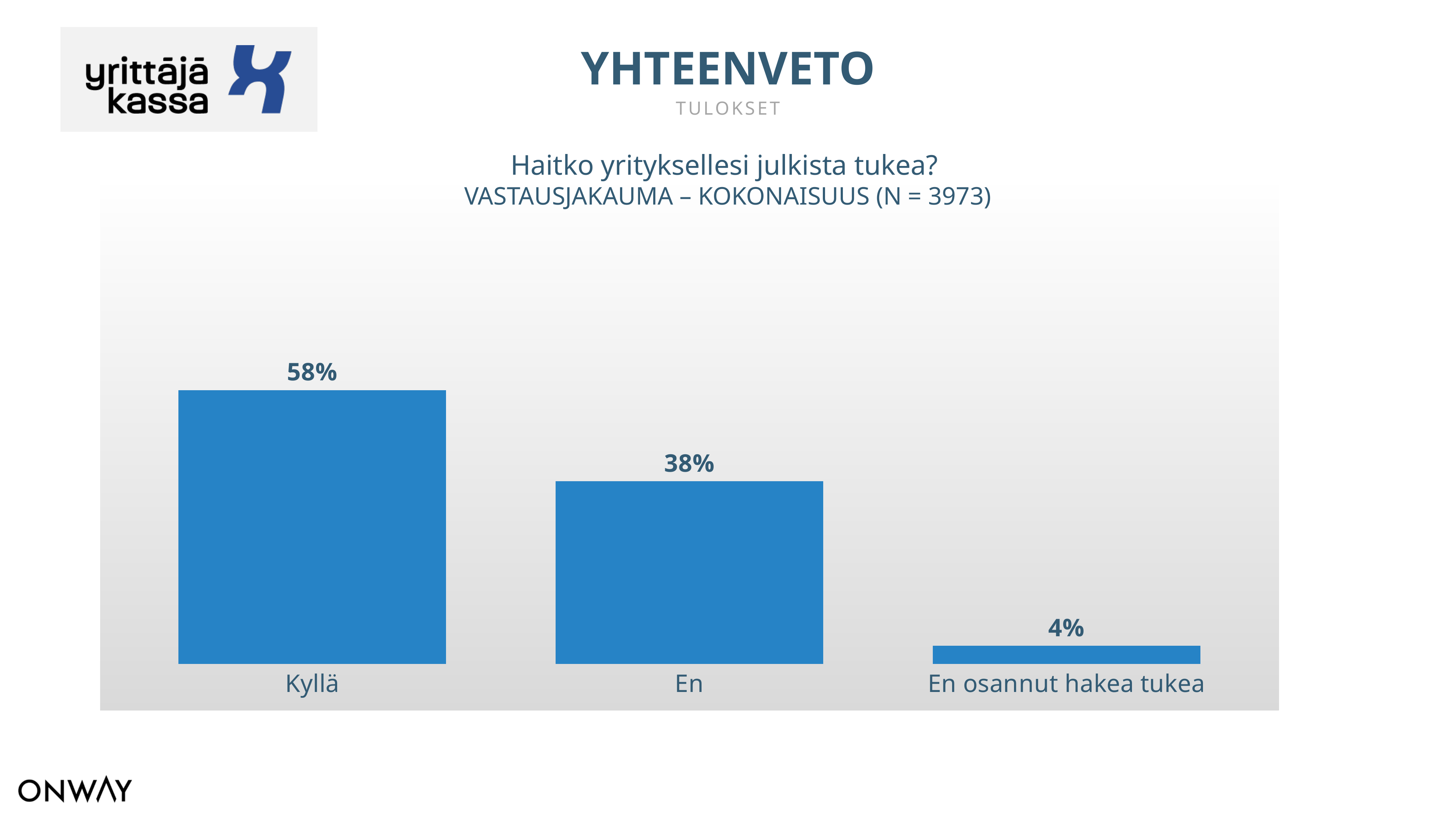
What is the value for Kyllä? 58% Which category has the highest value? Kyllä What is the value for En osannut hakea tukea? 4% Do the values rise or fall from left to right across the categories? Fall What is the difference between the values for En and En osannut hakea tukea? 34% Which is larger, the value for Kyllä or the value for En? Kyllä Which category has the lowest value? En osannut hakea tukea What kind of chart is shown on the slide? Bar chart What is the difference between the values for Kyllä and En? 20% How many categories are shown in the chart? 3 What is the N value stated in the chart subtitle? 3973 What is the value for En? 38%